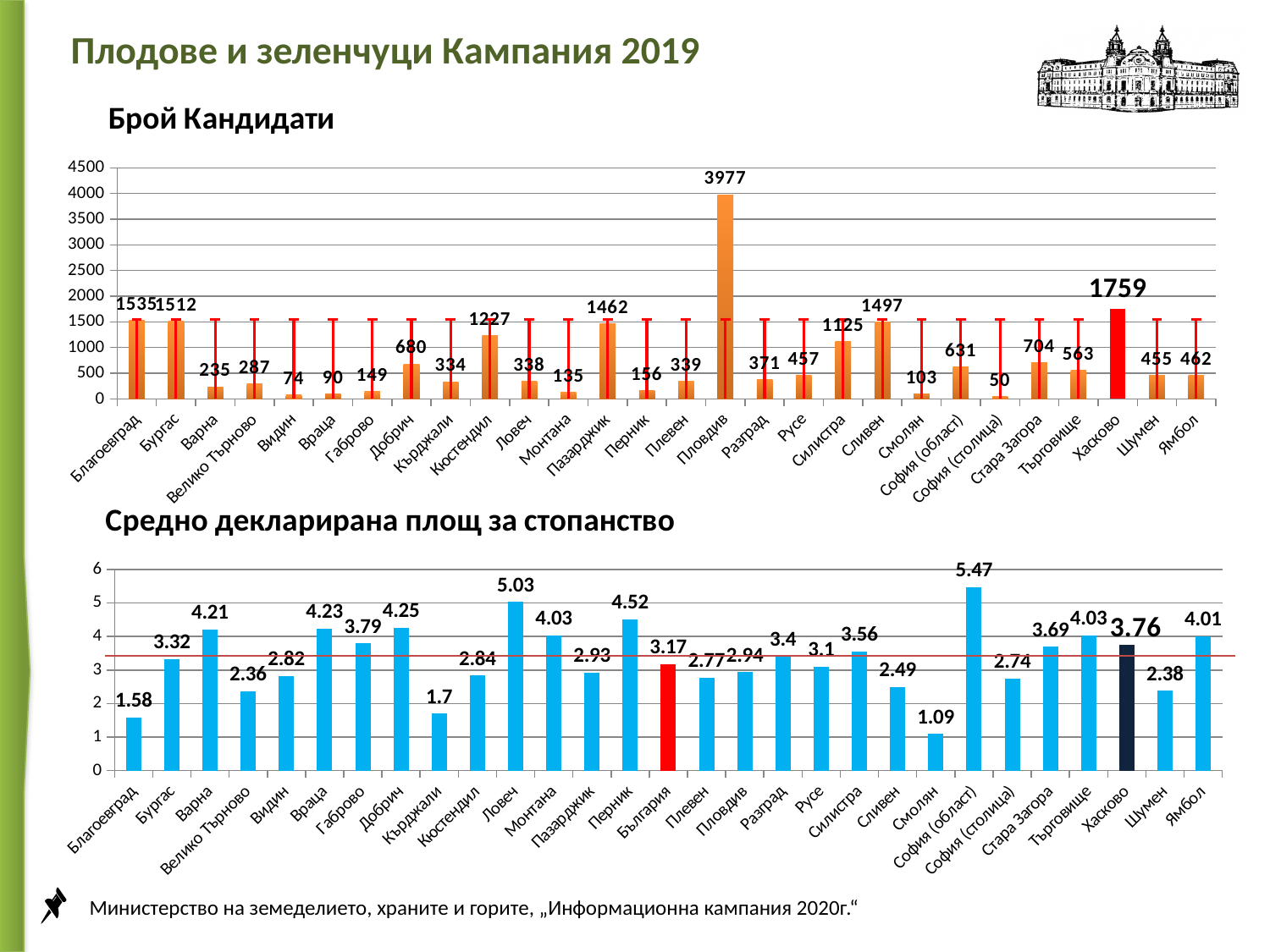
In the 'Брой Кандидати' chart, which category has the highest value? Пловдив In the 'Средно декларирана площ за стопанство' chart, which category has the lowest value? Смолян What type of chart is the 'Брой Кандидати' chart? Bar chart In the 'Средно декларирана площ за стопанство' chart, what is the difference between the values for Ловеч and Кърджали? 3.33 In the 'Брой Кандидати' chart, what is the value for Пловдив? 3977 In the 'Брой Кандидати' chart, which is larger, the value for Сливен or the value for Пазарджик? Сливен In the 'Брой Кандидати' chart, which category has the lowest value? София (столица) In the 'Брой Кандидати' chart, what is the difference between the values for Благоевград and Бургас? 23 In the 'Средно декларирана площ за стопанство' chart, what is the value for България? 3.17 In the 'Средно декларирана площ за стопанство' chart, how many categories are shown on the x axis? 29 In the 'Брой Кандидати' chart, what is the value for Хасково? 1759 In the 'Средно декларирана площ за стопанство' chart, what is the value for София (област)? 5.47